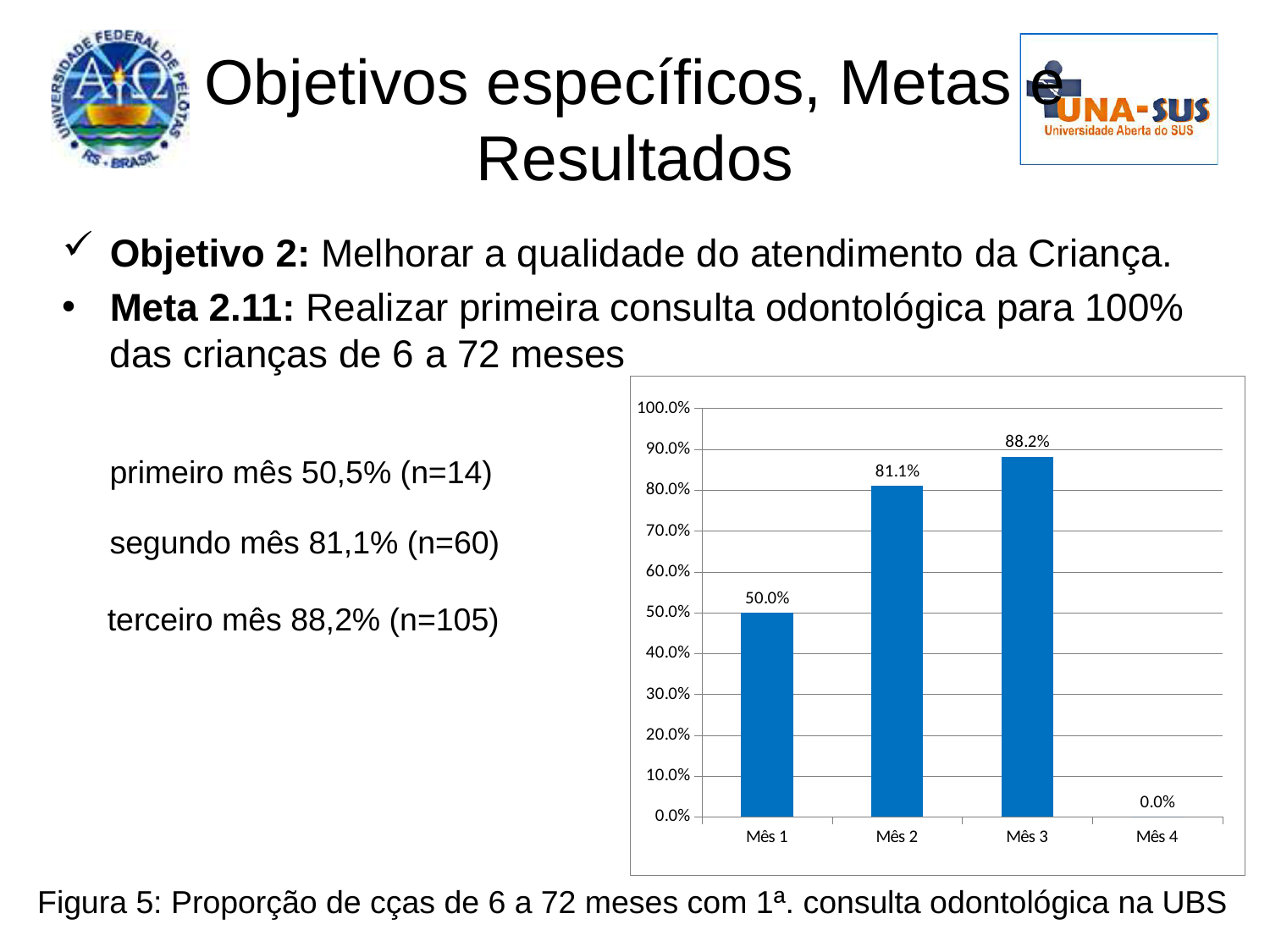
What is the value for Mês 1 in the bar chart? 50.0% Do the values rise or fall from Mês 1 to Mês 3? Rise Which month has the lowest value in the bar chart? Mês 4 What is the value for Mês 2 in the bar chart? 81.1% What is the difference between the values for Mês 3 and Mês 2? 7.1 percentage points What kind of chart is shown on the slide? Bar chart What is the value for Mês 4 in the bar chart? 0.0% Which is larger, the value for Mês 1 or the value for Mês 2? Mês 2 Which month has the highest value in the bar chart? Mês 3 What is the difference between the values for Mês 2 and Mês 1? 31.1 percentage points What is the value for Mês 3 in the bar chart? 88.2% How many months (categories) are shown on the x axis of the chart? 4